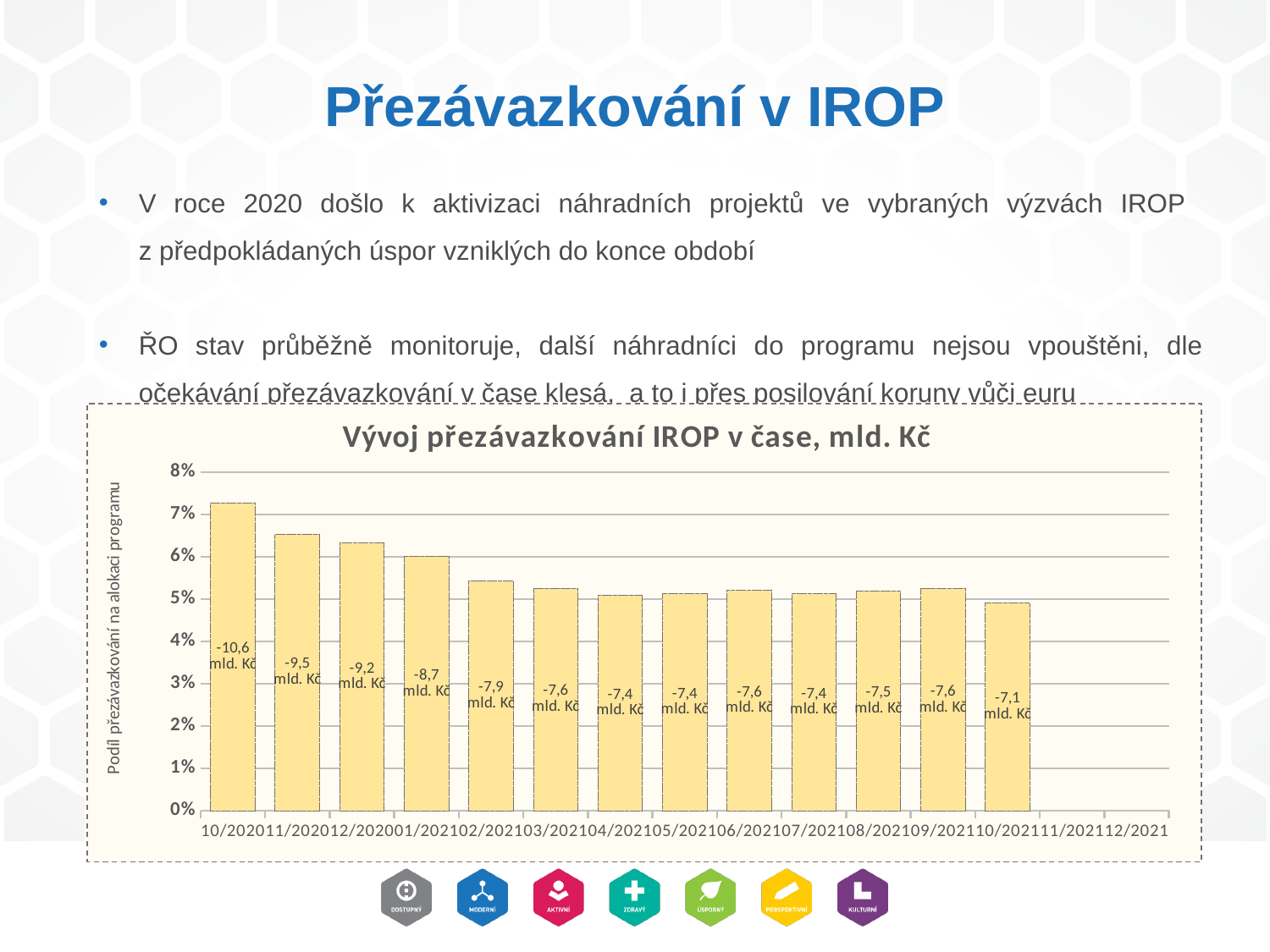
What is the title of the chart? Vývoj přezávazkování IROP v čase, mld. Kč Do the values generally rise or fall from left to right along the x axis? fall Which bar has the highest share of the programme allocation? 10/2020 Which bar has the lowest share of the programme allocation? 10/2021 How many bars are plotted in the chart? 13 What kind of chart is shown on the slide? bar chart Is the value for the first bar (10/2020) greater or less than 7%? greater Is the value for the last bar (10/2021) greater or less than 5%? less What is the data label on the last bar (10/2021)? -7,1 mld. Kč What is the data label on the first bar (10/2020)? -10,6 mld. Kč What is the label of the vertical axis? Podíl přezávazkování na alokaci programu What is the data label on the second bar (11/2020)? -9,5 mld. Kč